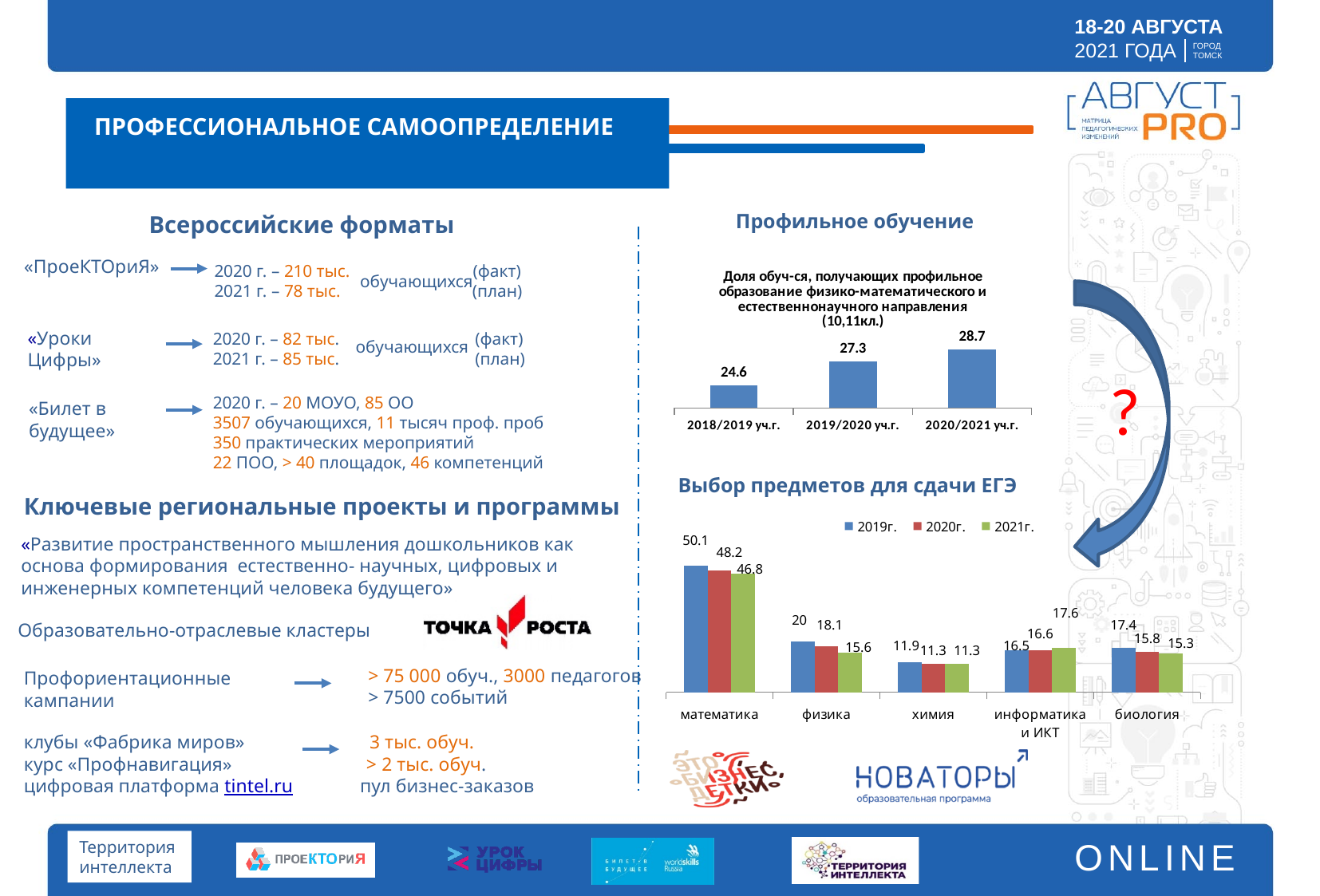
How many series does the legend of the 'Выбор предметов для сдачи ЕГЭ' chart list? 3 In the 'Профильное обучение' chart, what is the difference between the 2019/2020 уч.г. and 2018/2019 уч.г. values? 2.7 In the 'Выбор предметов для сдачи ЕГЭ' chart, what is the difference between the 2019г. and 2021г. values for математика? 3.3 How many categories are shown in the 'Профильное обучение' chart? 3 In the 'Выбор предметов для сдачи ЕГЭ' chart, which subject has the highest value in 2021г.? математика In the 'Профильное обучение' chart, do the values rise or fall from 2018/2019 to 2020/2021? rise In the 'Выбор предметов для сдачи ЕГЭ' chart, what is the value for физика in 2021г.? 15.6 What type of chart is the 'Выбор предметов для сдачи ЕГЭ' chart? bar chart In the 'Профильное обучение' chart, what is the value for 2020/2021 уч.г.? 28.7 In the 'Выбор предметов для сдачи ЕГЭ' chart, what is the value for математика in 2019г.? 50.1 In the 'Выбор предметов для сдачи ЕГЭ' chart, which is larger: биология in 2019г. or информатика и ИКТ in 2019г.? биология in 2019г. In the 'Профильное обучение' chart, which academic year has the lowest value? 2018/2019 уч.г.